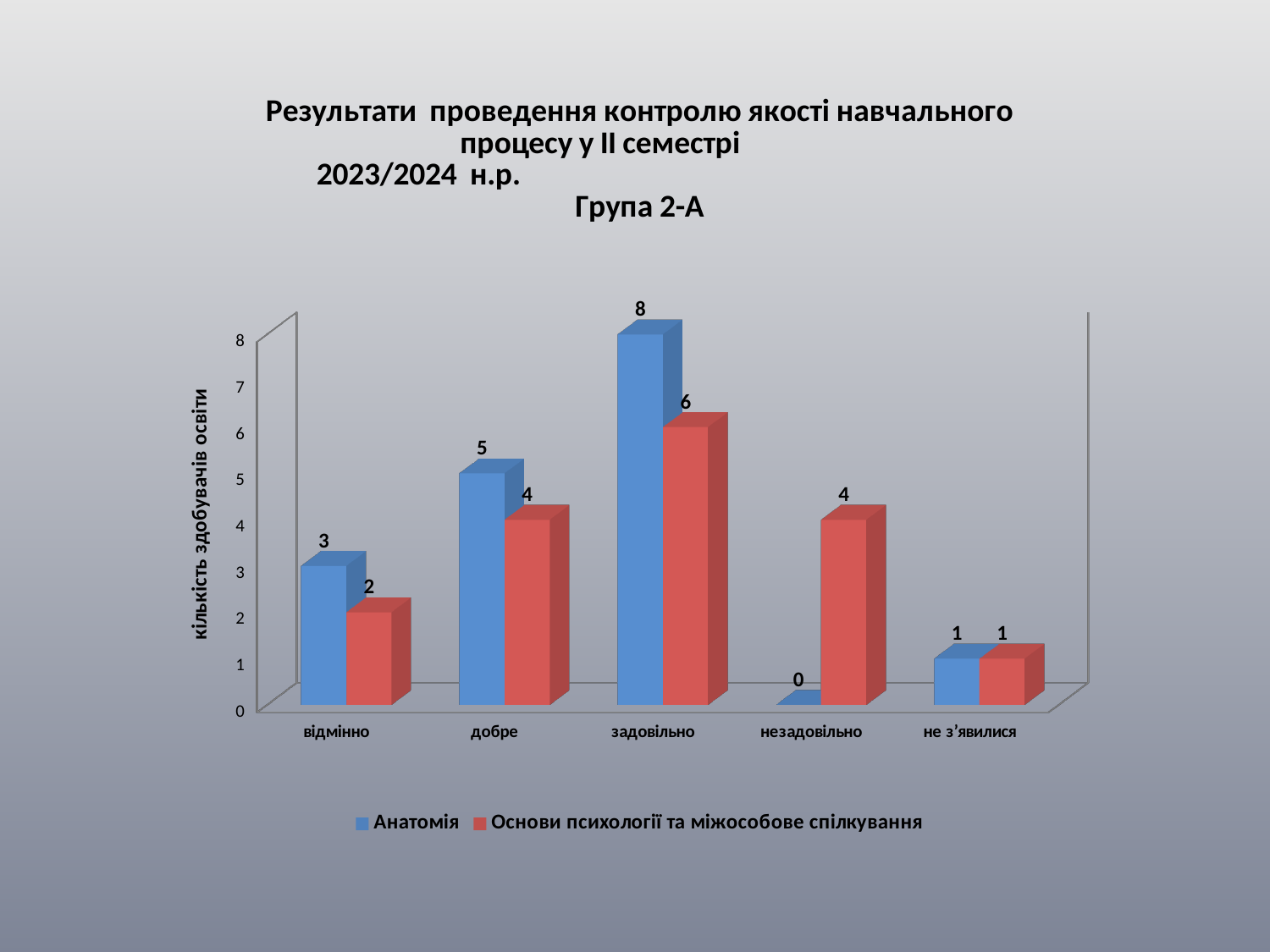
What is the value for Анатомія in the відмінно category? 3 How many categories are shown on the x axis? 5 In the відмінно category, which series has the larger value, Анатомія or Основи психології та міжособове спілкування? Анатомія How many series does the legend list? 2 Which category has the highest value for Анатомія? задовільно What kind of chart is shown on the slide? bar chart What is the difference between the Анатомія and Основи психології та міжособове спілкування values in the добре category? 1 Which group is named in the chart title? Група 2-А Which category has the lowest value for Анатомія? незадовільно What is the value for Анатомія in the задовільно category? 8 What is the y-axis label of the chart? кількість здобувачів освіти What is the value for Основи психології та міжособове спілкування in the незадовільно category? 4